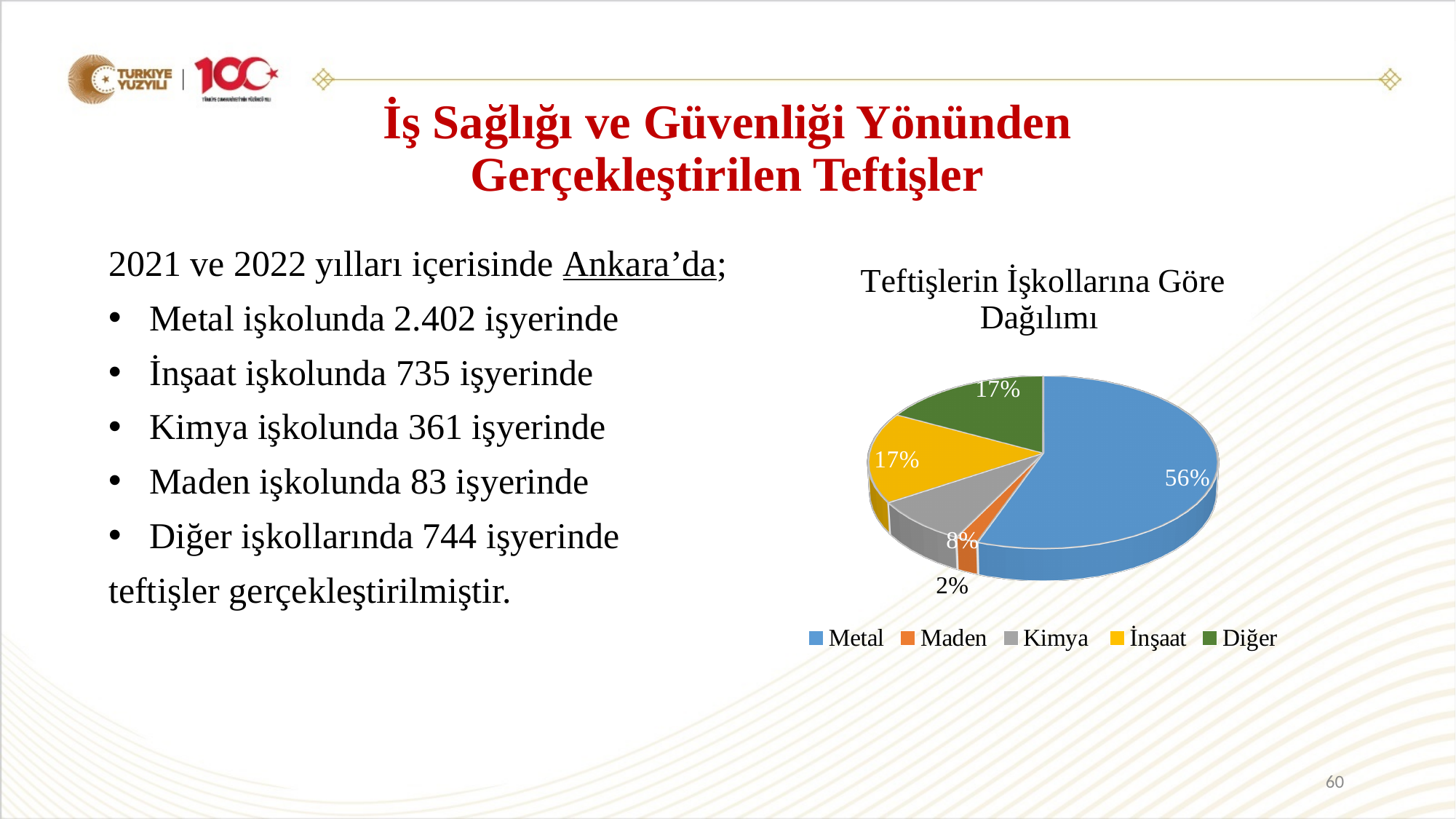
What is the title of the chart? Teftişlerin İşkollarına Göre Dağılımı What share of the pie does İnşaat have? 17% What percentage is shown for Diğer? 17% How many categories does the pie chart show? 5 What percentage is shown for Maden? 2% What percentage is shown for Kimya? 8% Which category has the smallest slice of the pie? Maden What share of the pie does Metal have? 56% What is the difference in percentage points between Metal and Kimya? 48% Which is larger, the share for Kimya or the share for Maden? Kimya Which category has the largest slice of the pie? Metal What kind of chart is shown on the slide? Pie chart